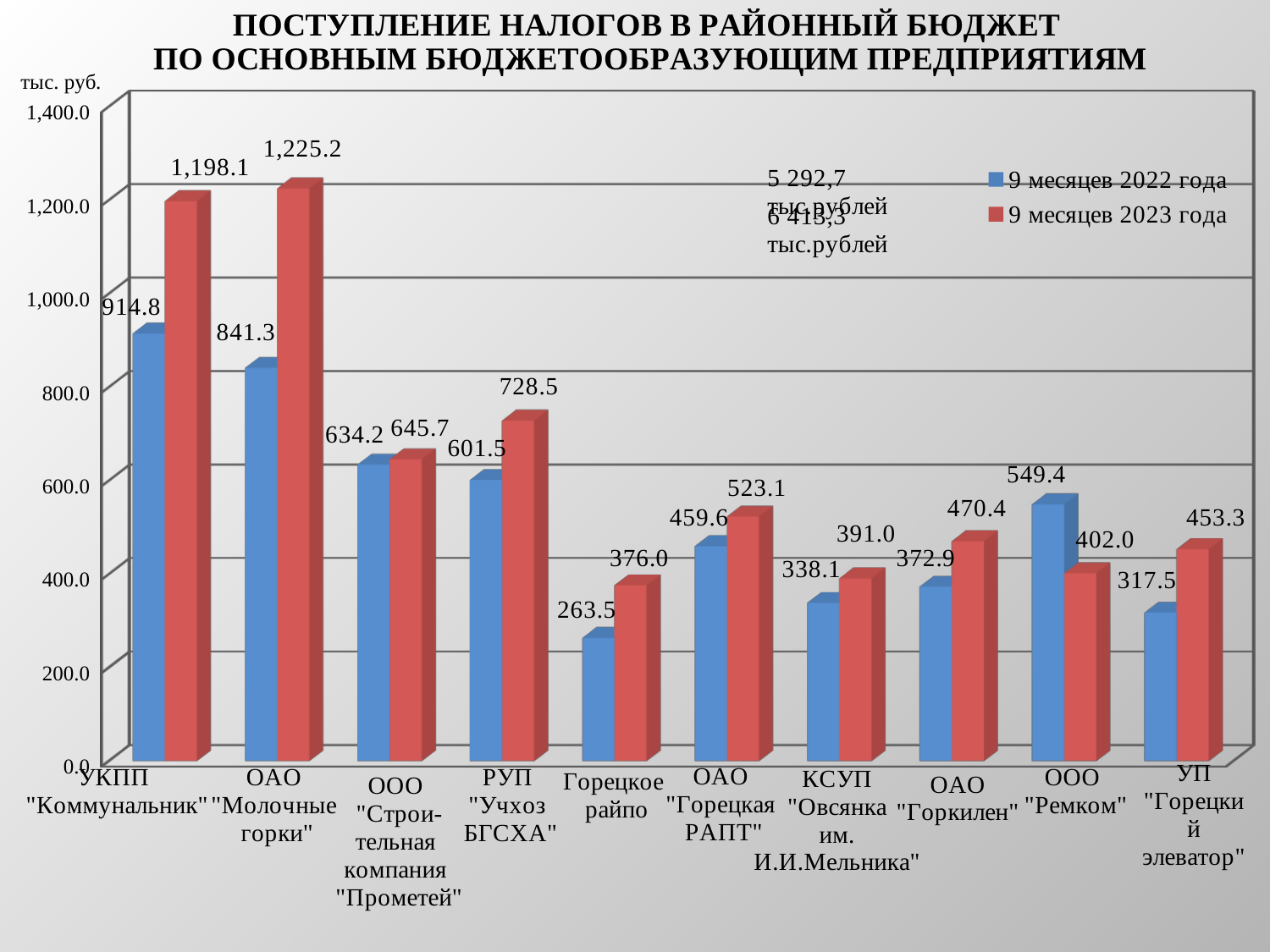
What is the value for ООО "Ремком" in the 9 месяцев 2023 года series? 402.0 Which category has the lowest value in the 9 месяцев 2022 года series? Горецкое райпо What kind of chart is shown on the slide? bar chart Is the 9 месяцев 2022 года value for ОАО "Горкилен" greater or less than 400.0? less How many categories (enterprises) are shown on the x axis? 10 How many series does the legend list? 2 What is the value for Горецкое райпо in the 9 месяцев 2022 года series? 263.5 What unit is shown on the vertical axis label? тыс. руб. Which category has the highest value in the 9 месяцев 2023 года series? ОАО "Молочные горки" For ООО "Ремком", which series has the larger value: 9 месяцев 2022 года or 9 месяцев 2023 года? 9 месяцев 2022 года What is the value for УКПП "Коммунальник" in the 9 месяцев 2023 года series? 1,198.1 What is the difference between the 9 месяцев 2023 года and 9 месяцев 2022 года values for РУП "Учхоз БГСХА"? 127.0